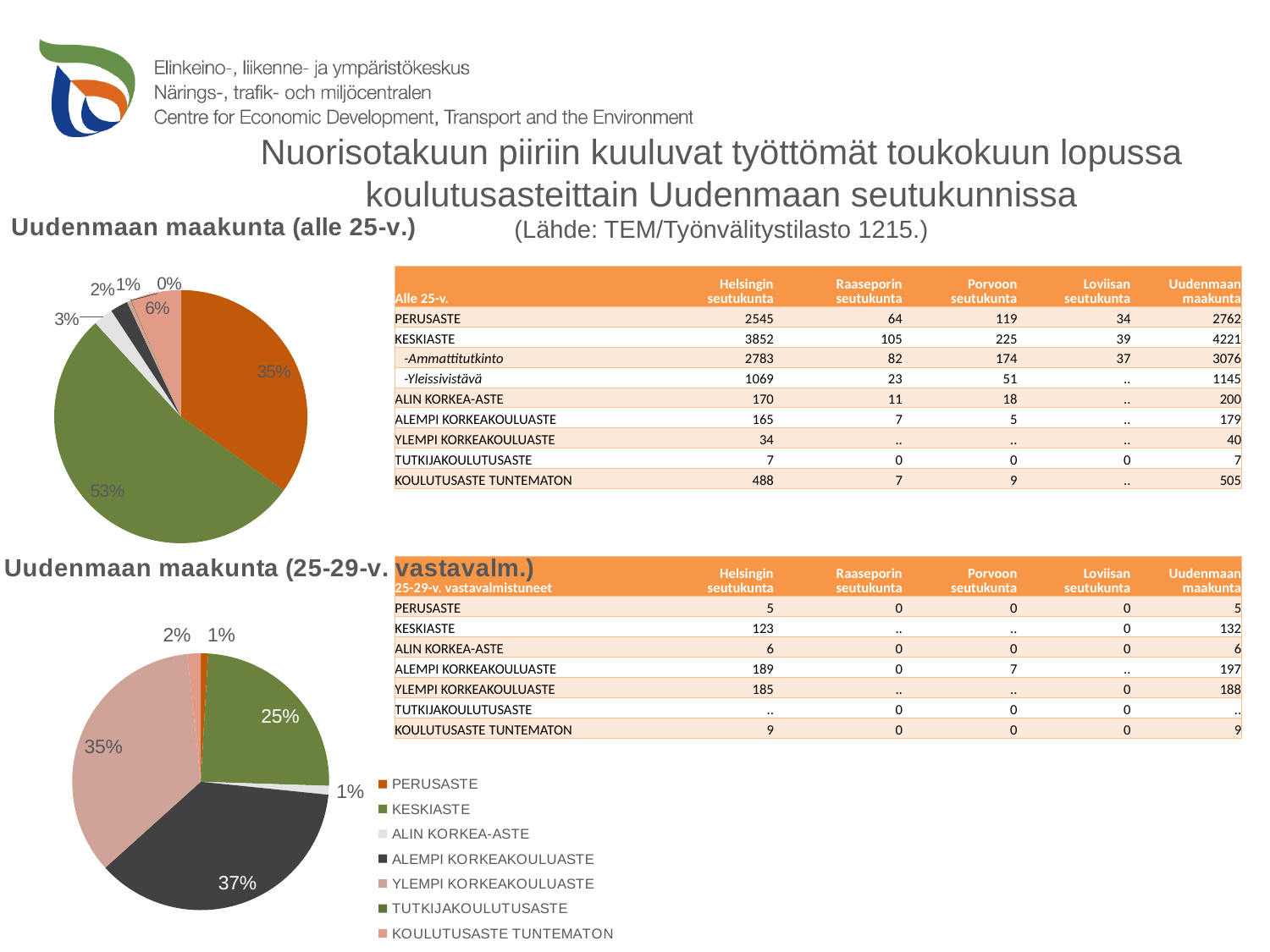
In the top pie chart (Uudenmaan maakunta, alle 25-v.), what share does the largest slice represent? 53% In the bottom pie chart (Uudenmaan maakunta, 25-29-v. vastavalm.), which is larger: the ALEMPI KORKEAKOULUASTE slice or the KESKIASTE slice? ALEMPI KORKEAKOULUASTE In the bottom pie chart (Uudenmaan maakunta, 25-29-v. vastavalm.), what share is shown for the green KESKIASTE slice? 25% What is the title of the top pie chart on the slide? Uudenmaan maakunta (alle 25-v.) What type of chart is used for Uudenmaan maakunta (alle 25-v.)? Pie chart In the bottom pie chart (Uudenmaan maakunta, 25-29-v. vastavalm.), what is the difference in percentage points between the 37% slice and the 25% slice? 12 percentage points In the bottom pie chart (Uudenmaan maakunta, 25-29-v. vastavalm.), what share is shown for the YLEMPI KORKEAKOULUASTE slice? 35% In the top pie chart (Uudenmaan maakunta, alle 25-v.), what share is shown for the orange PERUSASTE slice? 35% In the top pie chart (Uudenmaan maakunta, alle 25-v.), what share is shown for the KOULUTUSASTE TUNTEMATON slice? 6% How many education-level categories does the legend at the bottom of the slide list? 7 In the top pie chart (Uudenmaan maakunta, alle 25-v.), what is the difference in percentage points between the 53% slice and the 35% slice? 18 percentage points In the bottom pie chart (Uudenmaan maakunta, 25-29-v. vastavalm.), what share does the largest slice represent? 37%